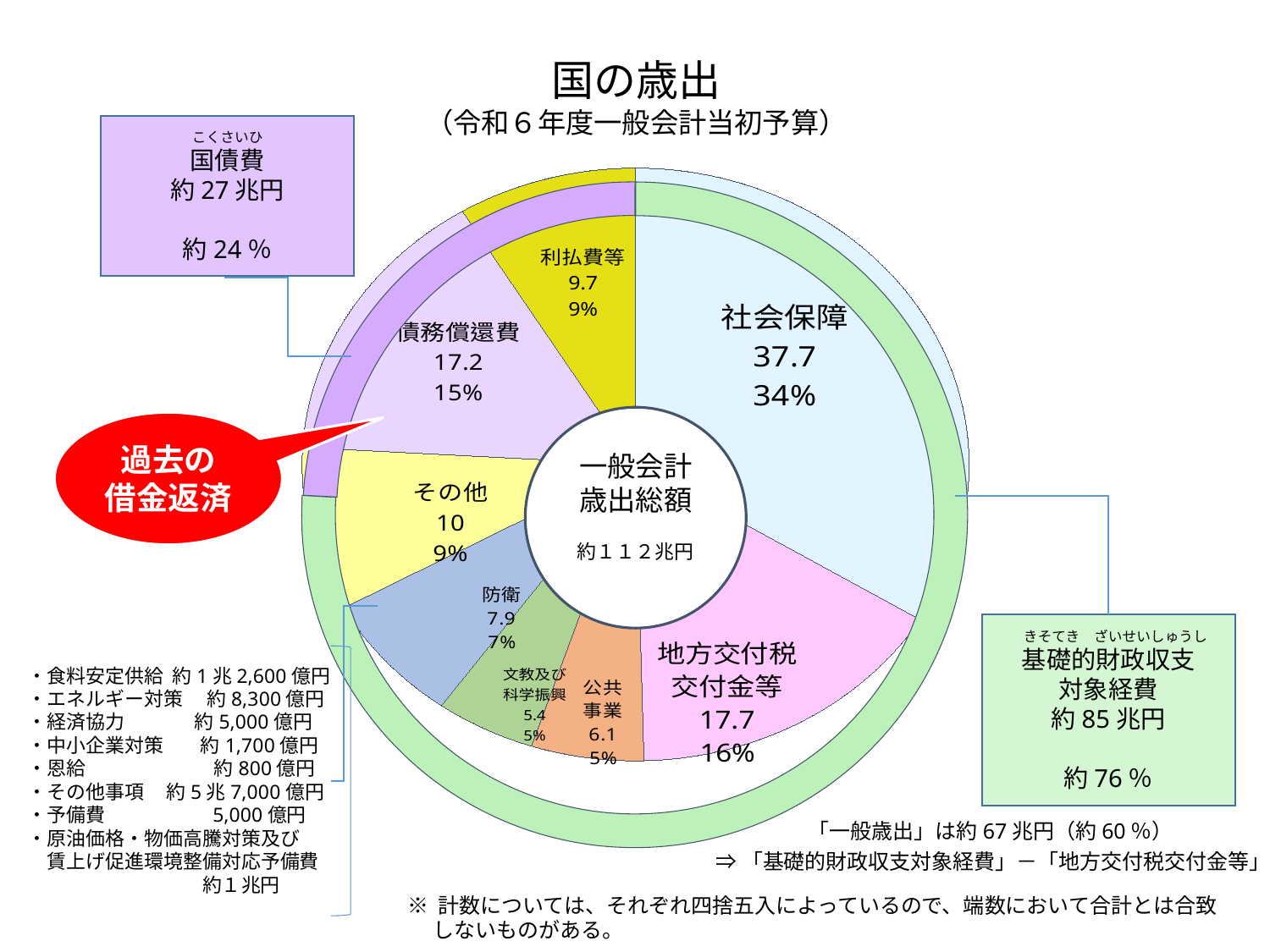
What percentage share does 債務償還費 have in the pie chart? 15% What is the value shown for 社会保障 in the pie chart? 37.7 Which category has the smallest slice in the pie chart? 文教及び科学振興 What is the value shown for 地方交付税交付金等? 17.7 Which category has the largest slice in the pie chart? 社会保障 What percentage share does 社会保障 have in the pie chart? 34% Which is larger, the value for 防衛 or the value for 公共事業? 防衛 What total amount is shown in the centre of the chart for 一般会計歳出総額? 約１１２兆円 What kind of chart is shown on the slide? pie chart What is the difference between the values for 社会保障 and 地方交付税交付金等? 20 What is the difference between the values for 債務償還費 and 利払費等? 7.5 How many categories (slices) are shown in the pie chart? 8